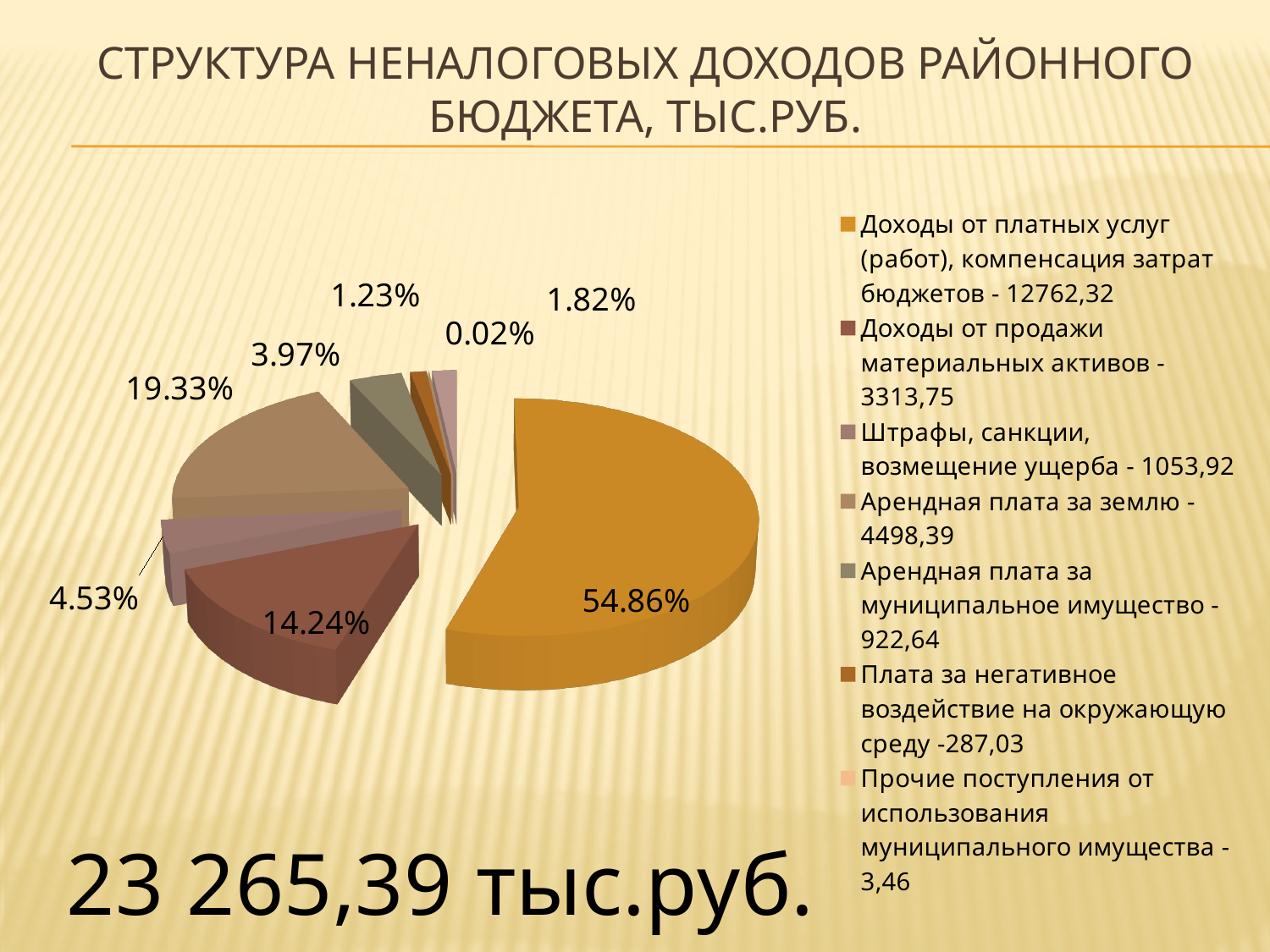
How many entries does the legend list? 7 What percentage share is labelled on the slice for Доходы от продажи материальных активов? 14.24% What is the difference between the legend values for Доходы от платных услуг (работ), компенсация затрат бюджетов and Доходы от продажи материальных активов? 9448,57 Which category has the largest share of the pie? Доходы от платных услуг (работ), компенсация затрат бюджетов What value does the legend give for Штрафы, санкции, возмещение ущерба? 1053,92 Which category has the smallest value in the legend? Прочие поступления от использования муниципального имущества What value does the legend give for Плата за негативное воздействие на окружающую среду? 287,03 What percentage share is labelled on the largest slice of the pie? 54.86% Which is larger: Доходы от продажи материальных активов or Арендная плата за землю? Арендная плата за землю What value does the legend give for Арендная плата за муниципальное имущество? 922,64 What kind of chart is shown on the slide? pie chart What percentage share is labelled on the slice for Арендная плата за землю? 19.33%